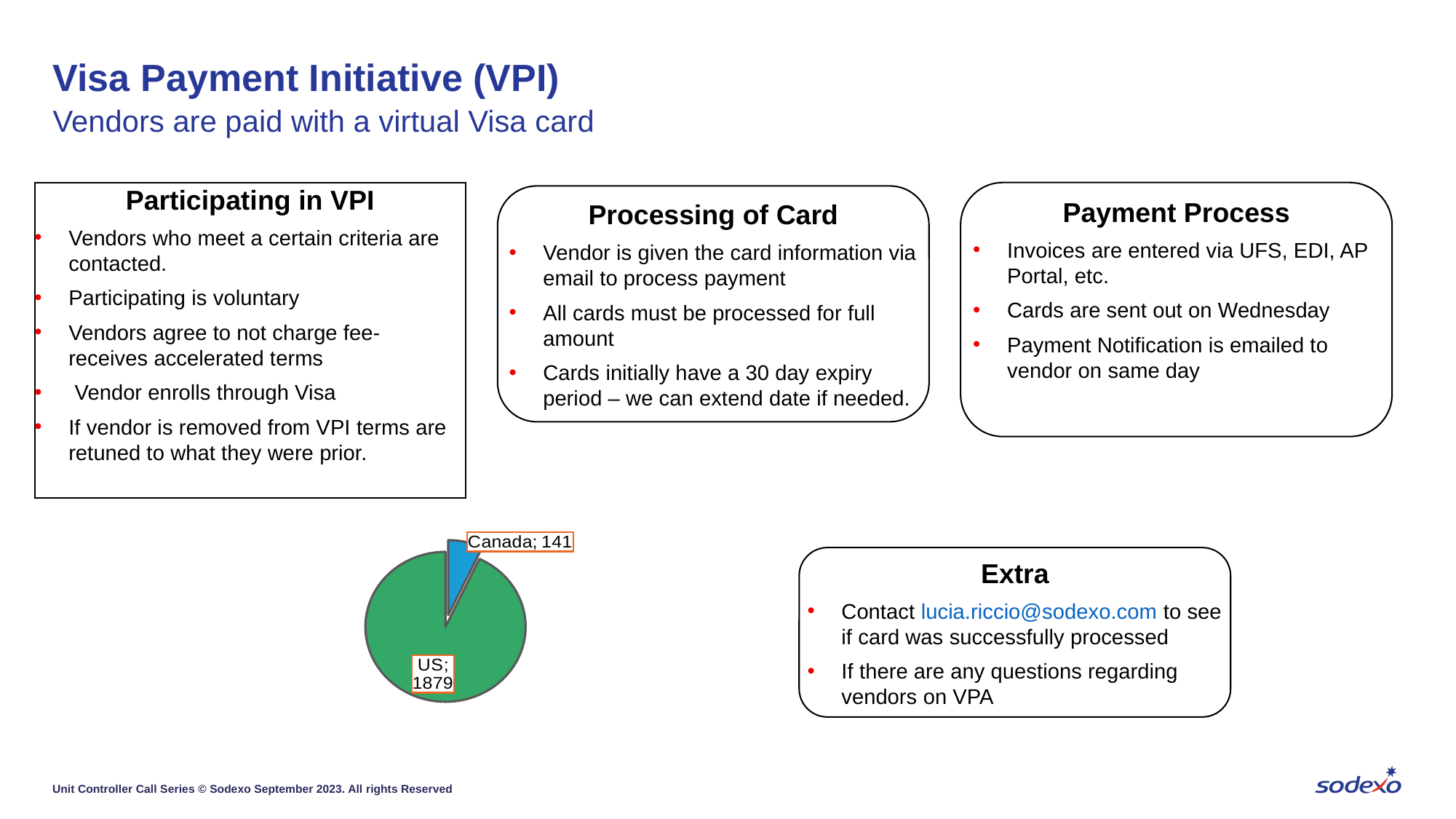
How many slices does the pie chart have? 2 What is the value for Canada in the pie chart? 141 What share of the pie chart does Canada represent, to the nearest whole percent? 7% Which category has the largest slice in the pie chart? US What is the total of the two values shown in the pie chart? 2020 What is the difference between the US value and the Canada value in the pie chart? 1738 Which is larger in the pie chart, US or Canada? US What type of chart is shown on the slide? pie chart What is the value for US in the pie chart? 1879 What colour is the Canada slice in the pie chart? blue What colour is the US slice in the pie chart? green Which category has the smallest slice in the pie chart? Canada